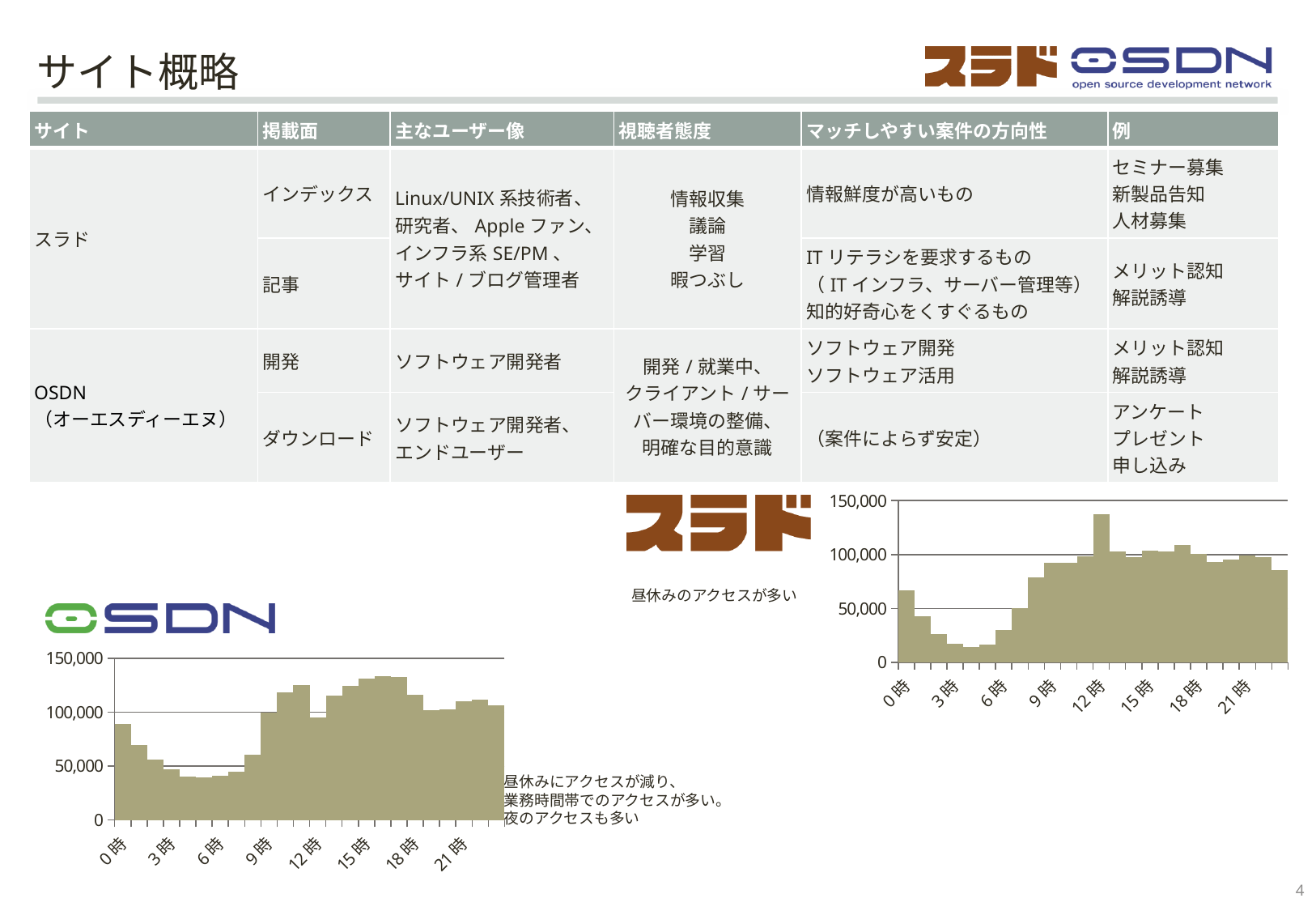
In the スラド chart, is the value for 3時 greater or less than 50,000? less In the スラド chart, is the value for 12時 greater or less than 100,000? greater In the OSDN chart, which is larger, the value for 15時 or the value for 3時? 15時 What kind of chart is the OSDN chart at the bottom left of the slide? bar chart How many hour labels are shown on the x axis of the OSDN chart? 8 In the スラド chart, do the values rise or fall from 3時 to 9時? rise In the スラド chart, which hour has the highest value? 12時 In the スラド chart, is the value for 0時 greater or less than 50,000? greater What kind of chart is the スラド chart on the right of the slide? bar chart In the スラド chart, which is larger, the value for 12時 or the value for 0時? 12時